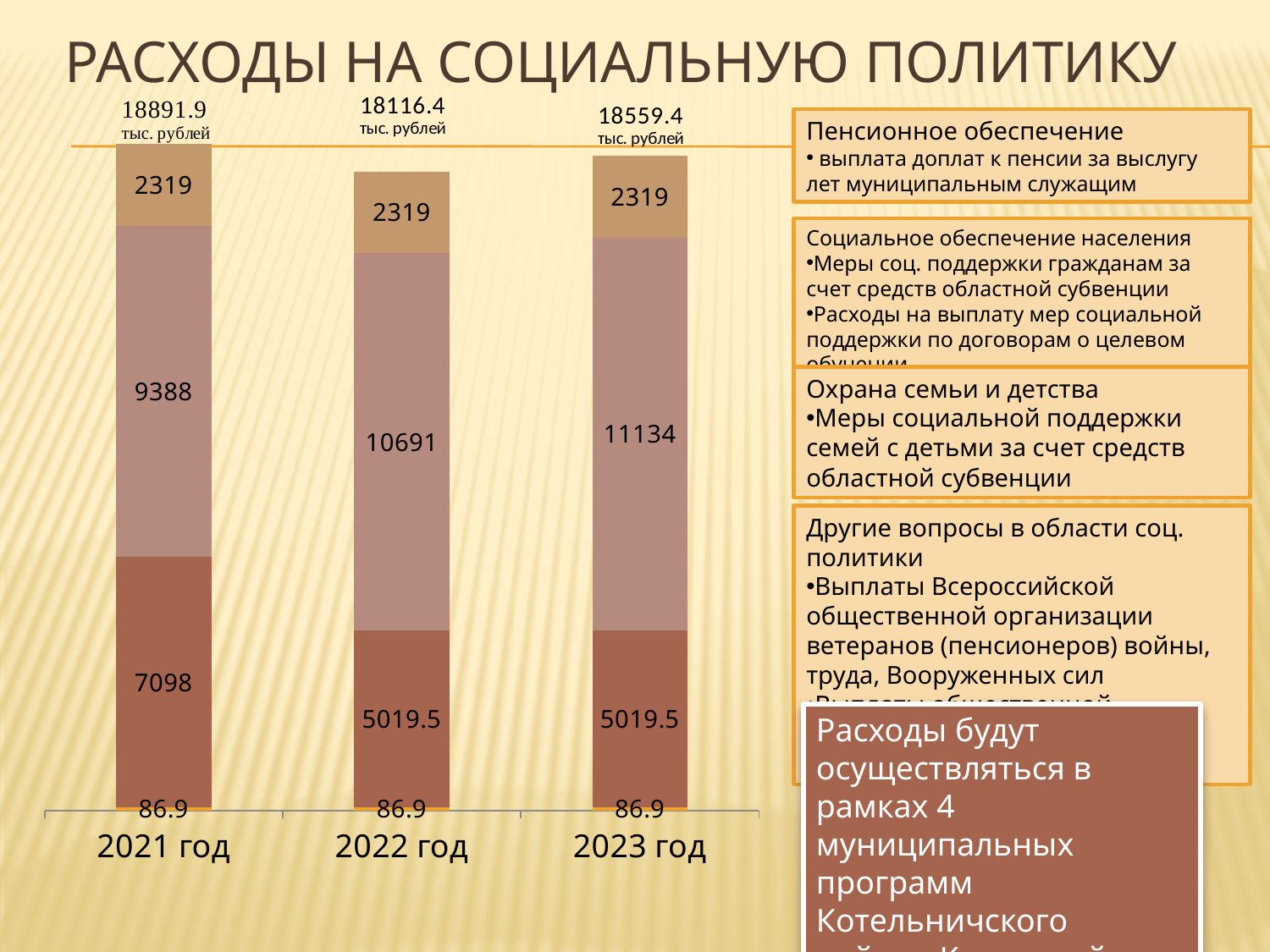
Which year has the highest total value? 2021 год How many years (bars) are shown on the chart? 3 Which year has the lowest total value? 2022 год What is the value of the dark brown segment of the 2021 год bar? 7098 Does the light pink segment rise or fall from 2021 год to 2023 год? rise What is the value of the largest (light pink) segment of the 2022 год bar? 10691 What is the total value printed above the bar for 2023 год? 18559.4 тыс. рублей What is the total value printed above the bar for 2022 год? 18116.4 тыс. рублей What kind of chart is shown on the slide? stacked bar chart What is the value of the top (light tan) segment of the 2023 год bar? 2319 What is the total value printed above the bar for 2021 год? 18891.9 тыс. рублей What is the difference between the light pink segment in 2023 год (11134) and in 2021 год (9388)? 1746